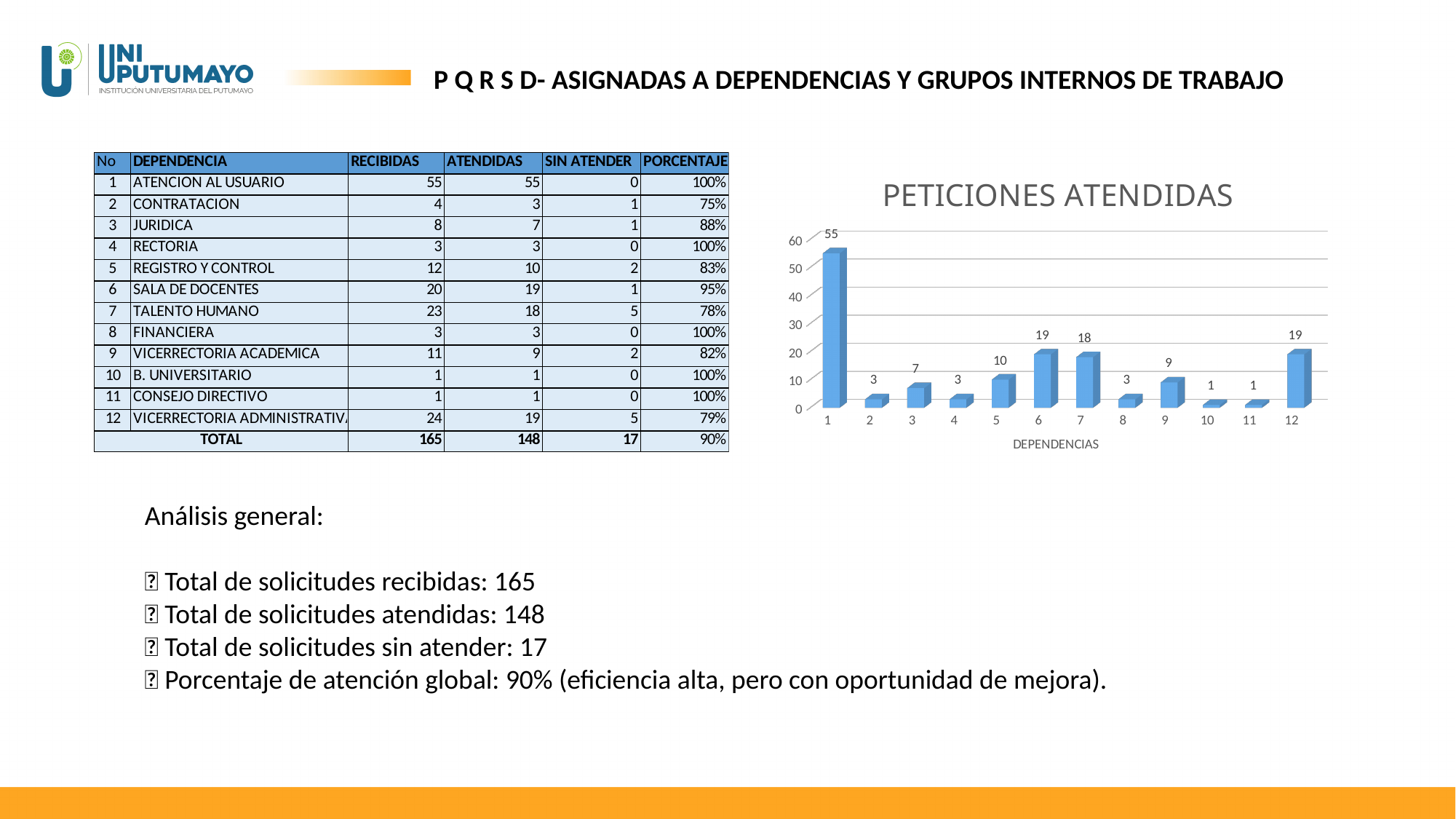
Which is larger, the value for category 5 or the value for category 9? category 5 What is the difference between the values for category 1 and category 12? 36 What is the value for category 7 in the chart? 18 What type of chart is shown on the slide? bar chart How many categories are plotted on the x axis of the chart? 12 What is the value for category 6 in the chart? 19 Is the value for category 1 greater or less than 50? greater What is the difference between the values for category 6 and category 7? 1 What is the x axis title of the chart? DEPENDENCIAS Which category has the highest value in the chart? 1 What is the title of the chart? PETICIONES ATENDIDAS What is the value for category 1 in the chart? 55